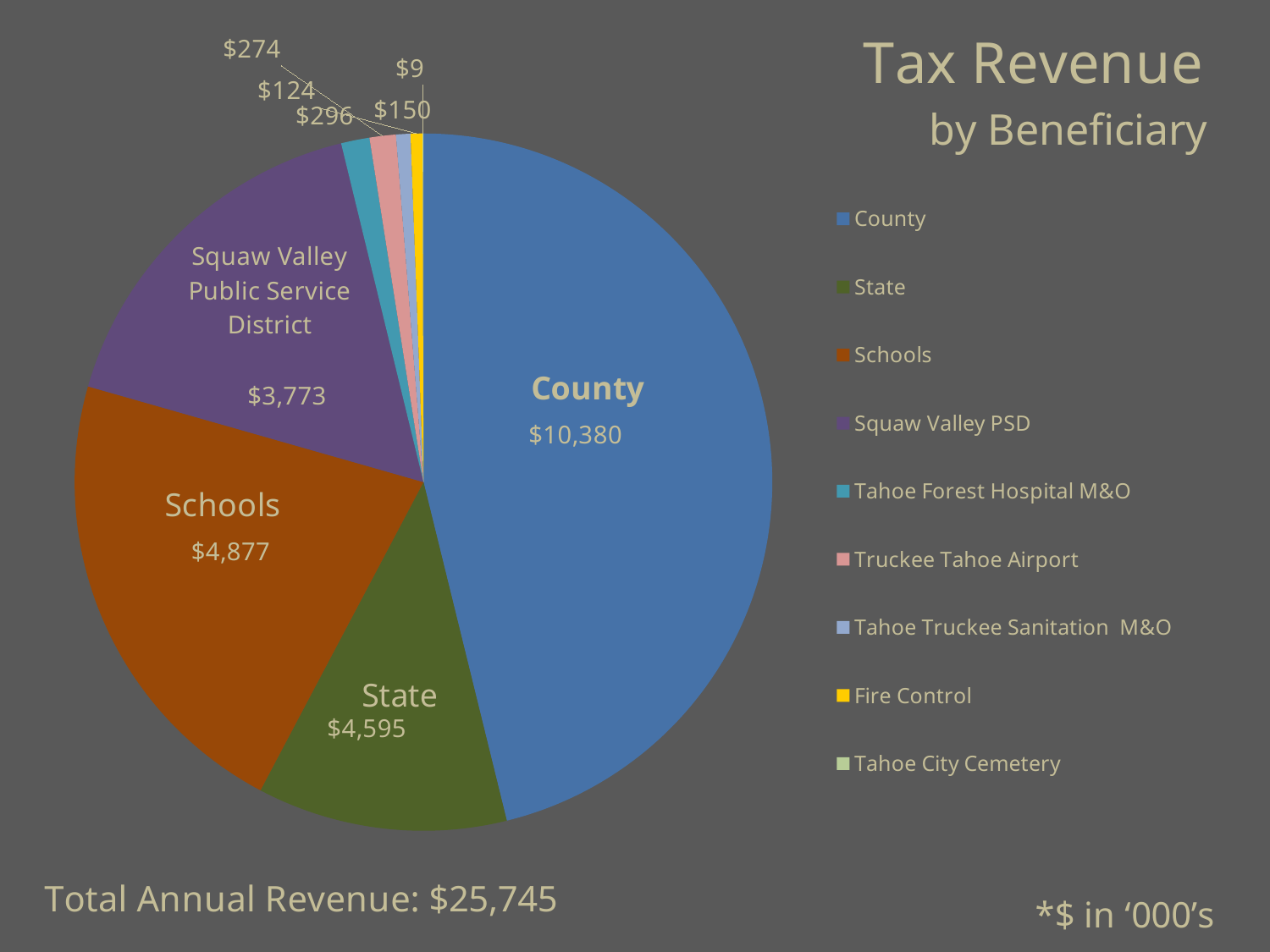
Which receives more tax revenue, Schools or State? Schools Which beneficiary receives the largest share of tax revenue? County What is the tax revenue value for Schools? $4,877 What kind of chart is shown on the slide? Pie chart What is the tax revenue value for County? $10,380 What is the total annual revenue shown on the slide? $25,745 What is the tax revenue value for State? $4,595 What is the difference between the County value and the Schools value? $5,503 What is the title of the chart? Tax Revenue by Beneficiary What is the tax revenue value for Squaw Valley Public Service District? $3,773 How many beneficiaries are listed in the legend? 9 What is the difference between the Schools value and the State value? $282